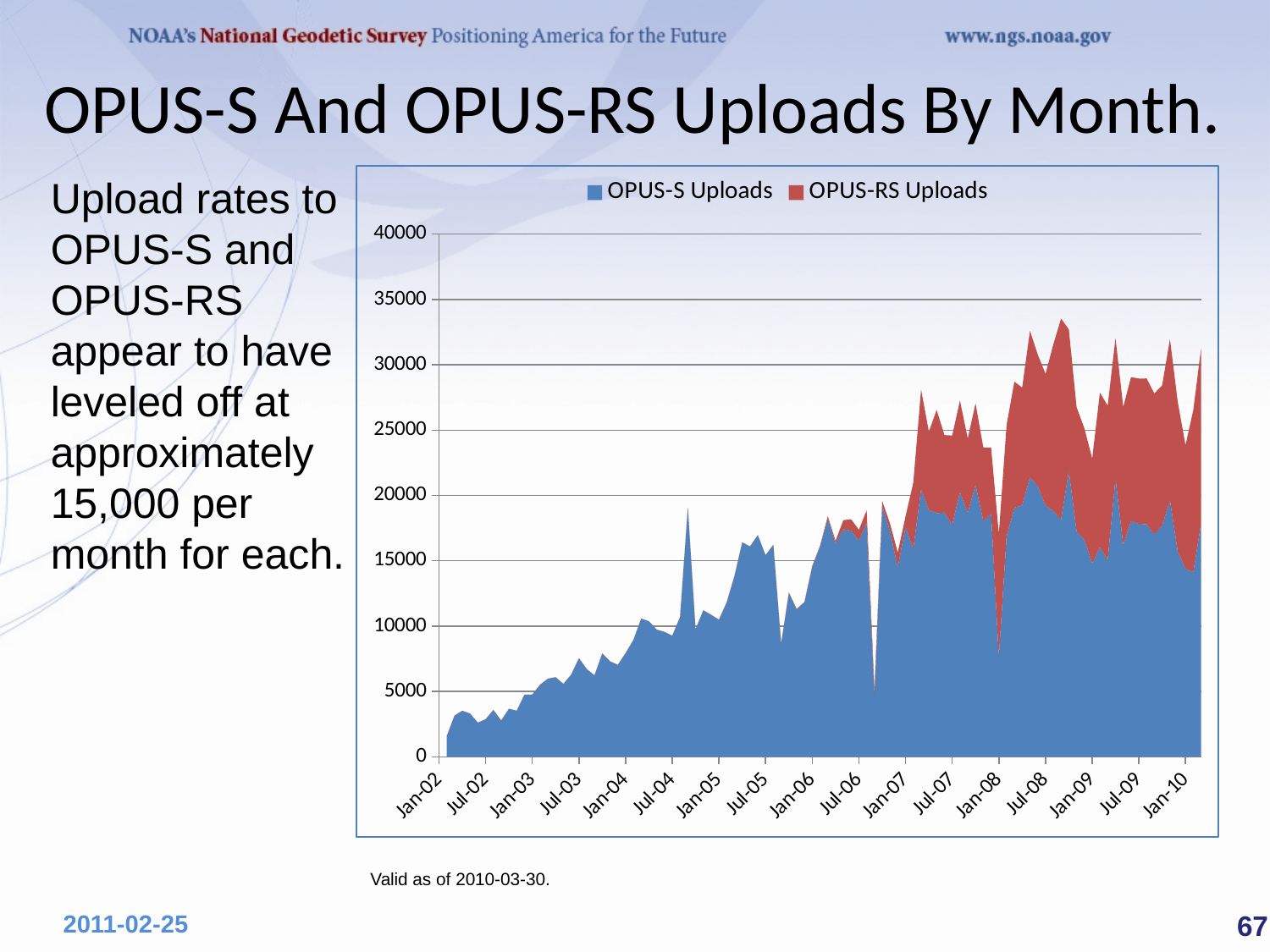
What are the two series named in the chart legend? OPUS-S Uploads and OPUS-RS Uploads How many month labels are shown along the x axis of the chart? 17 Is the OPUS-S Uploads value at Jan-02 greater or less than 5000? less Is the combined stacked total of uploads at Jan-10 greater or less than 25000? greater Do OPUS-S Uploads generally rise or fall from Jan-02 to Jan-10? rise What is the first month label on the chart's x axis? Jan-02 What is the last month label on the chart's x axis? Jan-10 Which colour represents OPUS-RS Uploads in the chart? red How many series does the chart legend list? 2 What is the highest value shown on the chart's y axis? 40000 Is the highest combined stacked total reached on the chart greater or less than 35000? less What kind of chart is shown on the slide? area chart